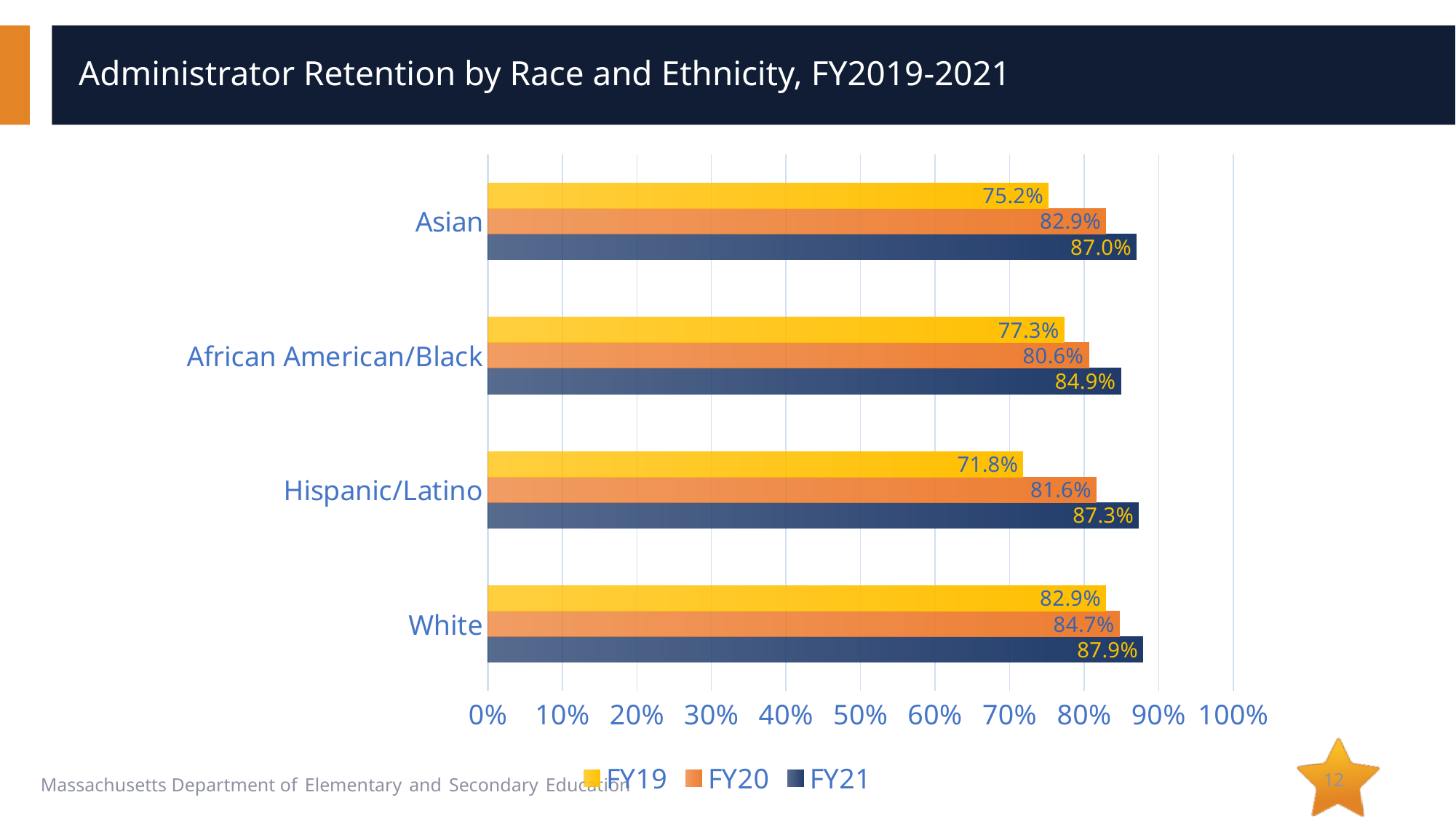
Which is larger, the FY20 retention rate for Asian administrators or the FY20 retention rate for White administrators? White How many series does the legend list? 3 How many race/ethnicity categories are shown on the chart? 4 What is the title of the chart on the slide? Administrator Retention by Race and Ethnicity, FY2019-2021 Is the FY19 retention rate for White administrators greater or less than 80%? greater What is the FY20 retention rate for African American/Black administrators? 80.6% What is the FY19 retention rate for Asian administrators? 75.2% What kind of chart is shown on the slide? Bar chart Which race/ethnicity group has the lowest FY19 retention rate? Hispanic/Latino What is the FY21 administrator retention rate for Hispanic/Latino administrators? 87.3% What is the difference between the FY21 and FY19 retention rates for Hispanic/Latino administrators? 15.5% Which race/ethnicity group has the highest FY21 retention rate? White